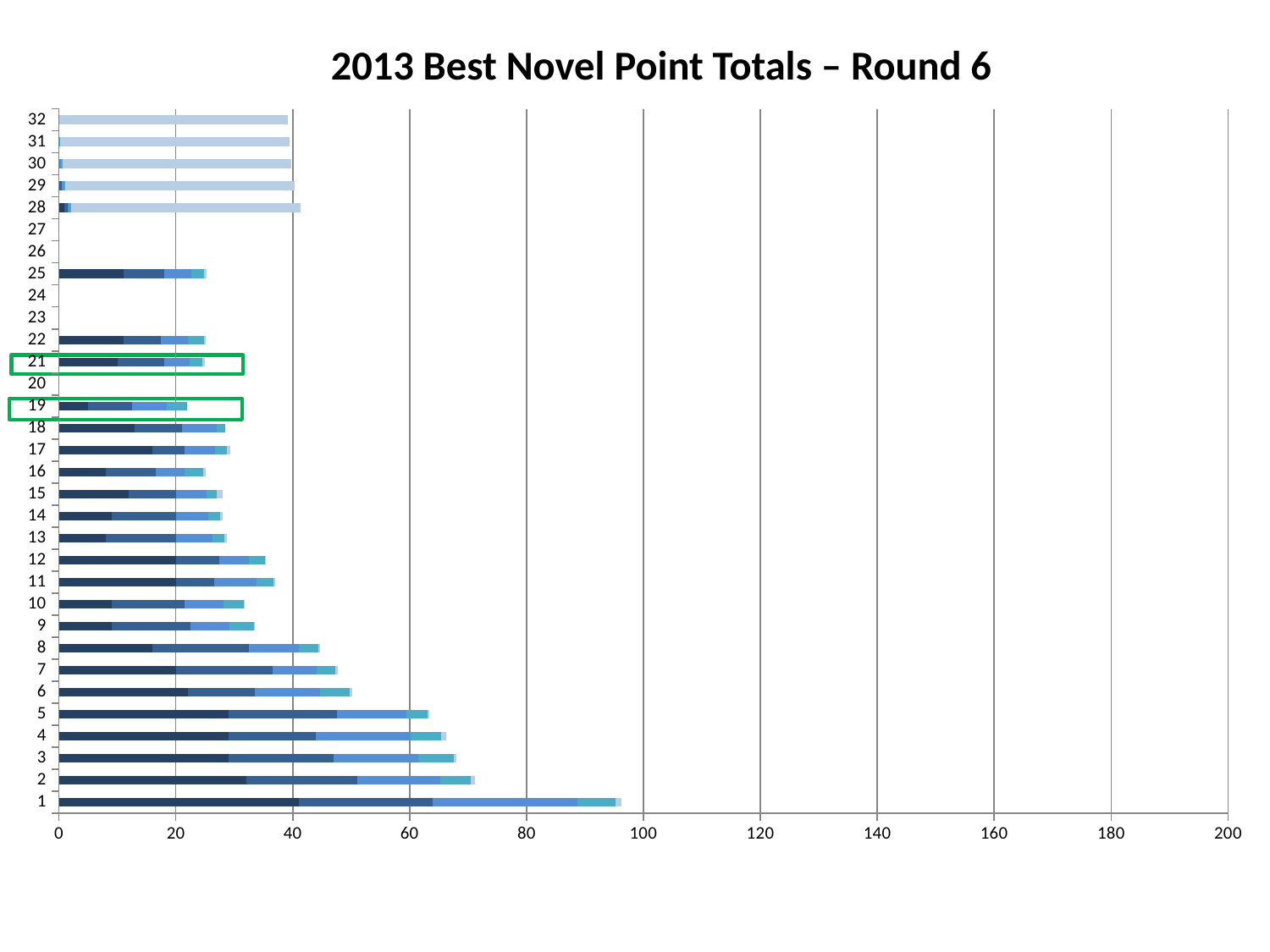
Is the value for category 16 greater or less than 20? greater How many categories on the chart have no bar at all? 5 Is the value for category 1 greater or less than 80? greater Which has a larger point total, category 3 or category 9? category 3 Which two categories are outlined with green boxes on the chart? 21 and 19 How many categories are listed on the vertical axis of the chart? 32 Is the value for category 12 greater or less than 40? less What kind of chart is shown on the slide? bar chart What is the title of the chart? 2013 Best Novel Point Totals – Round 6 Which category has the highest point total? 1